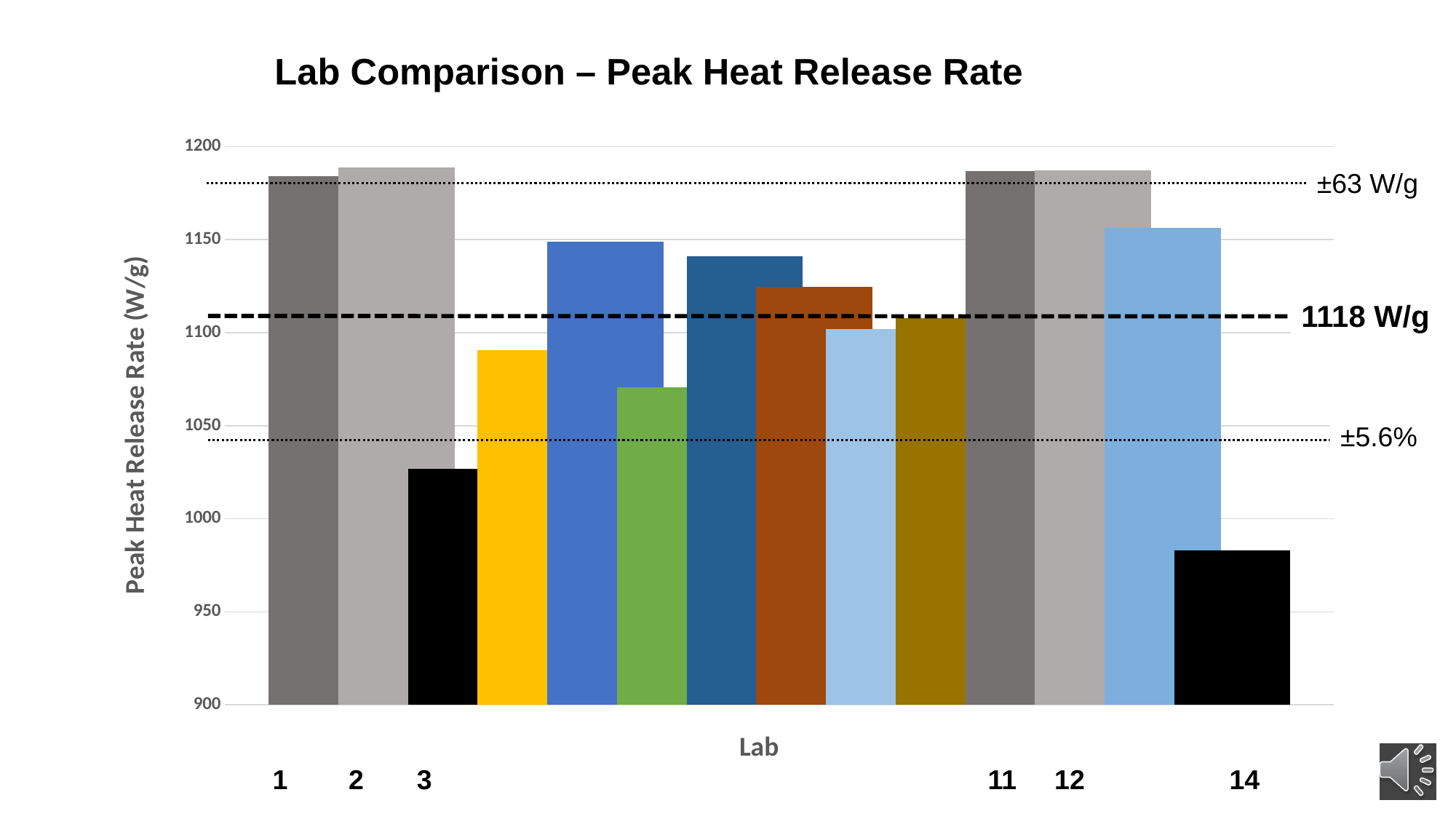
How many bars (labs) are plotted in the chart? 14 Which has the larger peak heat release rate, Lab 11 or Lab 14? Lab 11 Is the value for Lab 12 greater or less than 1150? greater Is the value for Lab 3 greater or less than 1050? less What kind of chart is shown on the slide? bar chart Is the value for Lab 1 greater or less than 1150? greater Which lab has the lowest peak heat release rate? Lab 14 What value is labelled on the dashed horizontal line across the chart? 1118 W/g What is the title of the chart? Lab Comparison – Peak Heat Release Rate Which has the larger peak heat release rate, Lab 3 or Lab 14? Lab 3